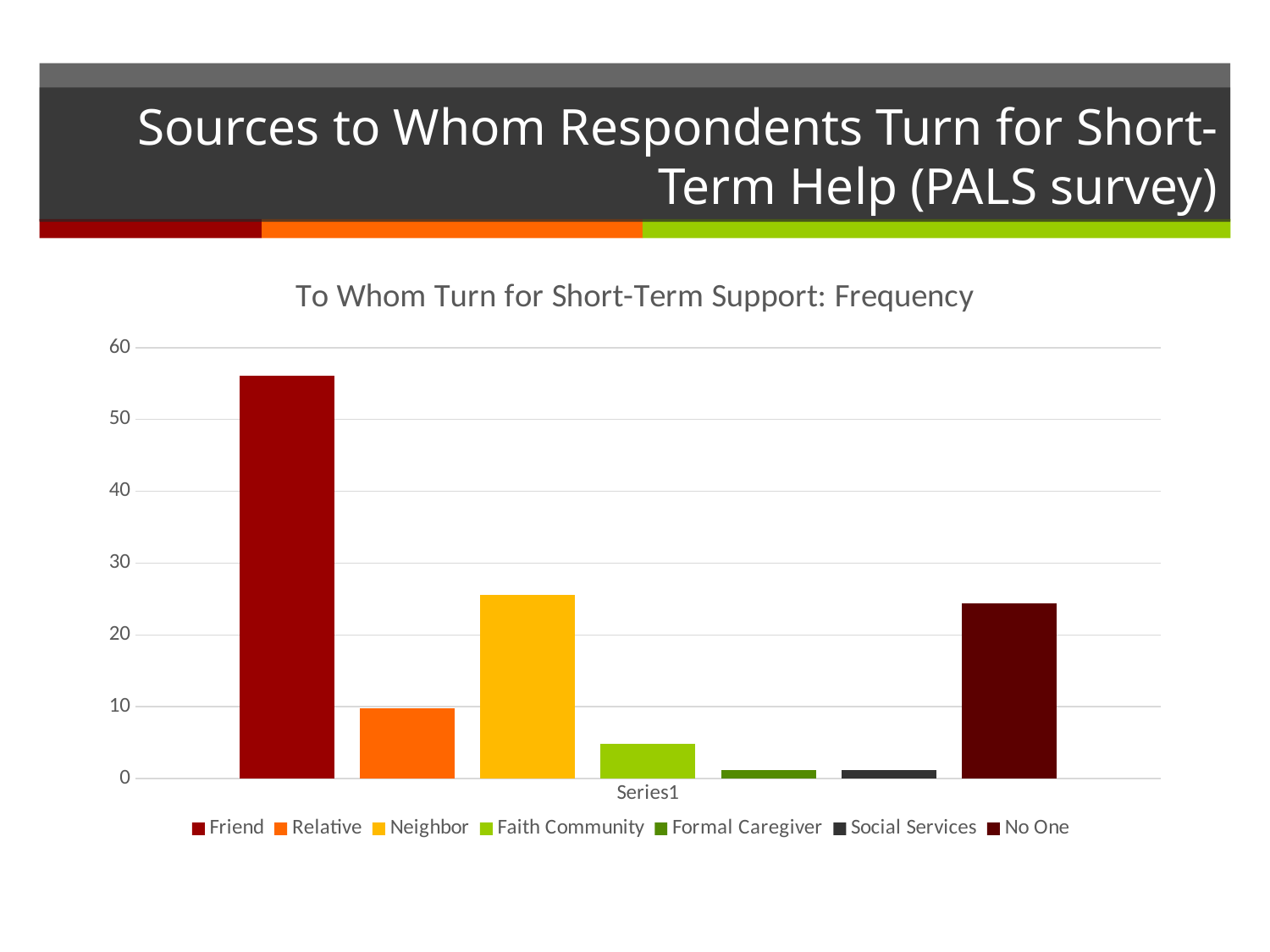
How many bars are plotted in the chart? 7 Is the value for Relative greater or less than 20? less Is the value for Neighbor greater or less than 20? greater Is the value for Friend greater or less than 50? greater Which is larger, the value for Relative or the value for No One? No One Which source has the highest bar? Friend What kind of chart is shown on the slide? bar chart How many series does the legend list? 7 What is the title of the chart? To Whom Turn for Short-Term Support: Frequency Which is larger, the value for Friend or the value for Neighbor? Friend